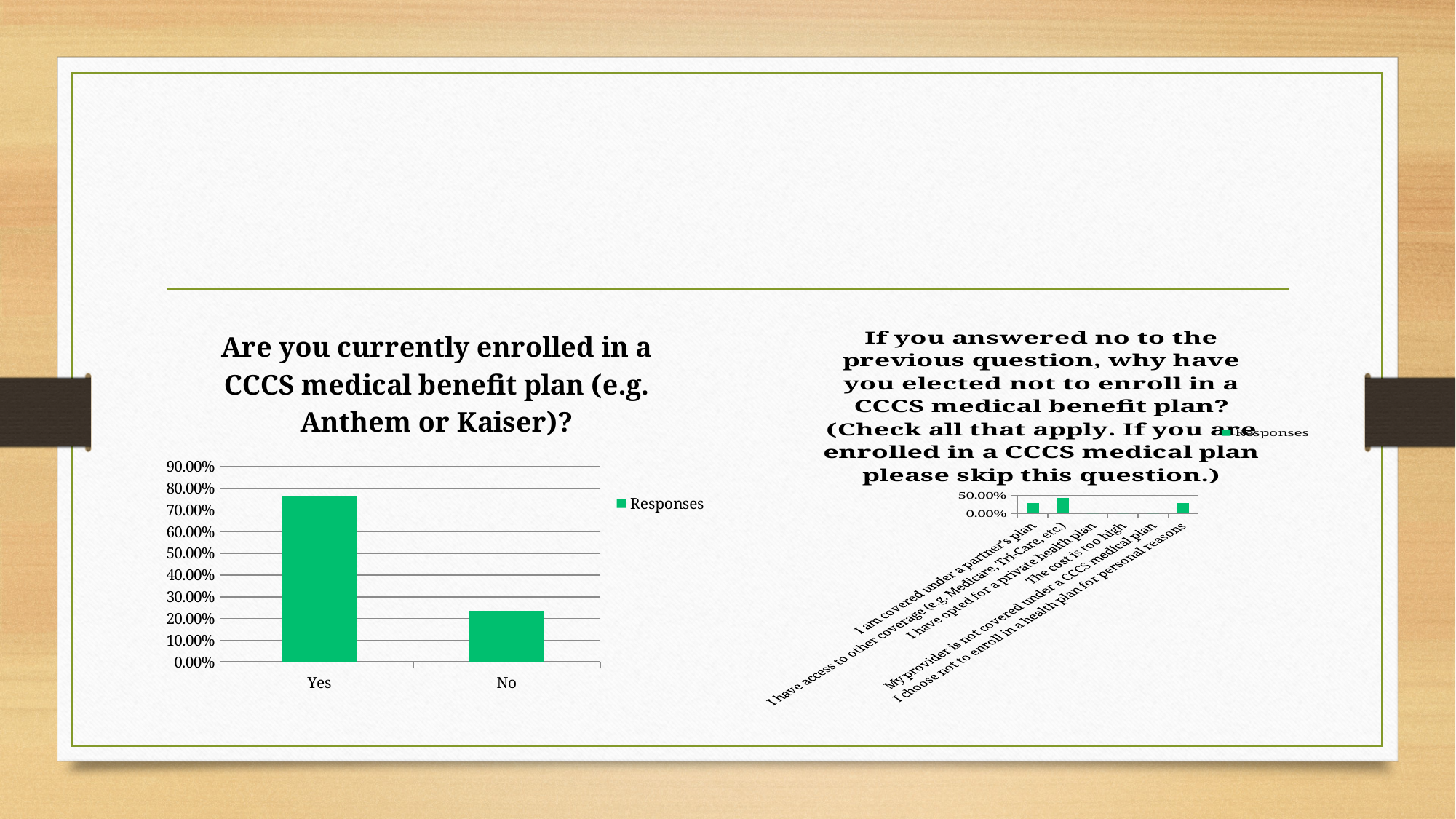
In the left chart ("Are you currently enrolled in a CCCS medical benefit plan"), which category has the highest value? Yes In the left chart ("Are you currently enrolled in a CCCS medical benefit plan"), is the value for No greater or less than 30.00%? less What is the name of the series in the legend of the left chart ("Are you currently enrolled in a CCCS medical benefit plan")? Responses In the left chart ("Are you currently enrolled in a CCCS medical benefit plan"), is the value for Yes greater or less than 80.00%? less How many categories are shown on the x axis of the left chart ("Are you currently enrolled in a CCCS medical benefit plan")? 2 In the left chart ("Are you currently enrolled in a CCCS medical benefit plan"), which category has the lowest value? No In the left chart ("Are you currently enrolled in a CCCS medical benefit plan"), is the value for Yes greater or less than 70.00%? greater How many series does the legend of the left chart ("Are you currently enrolled in a CCCS medical benefit plan") list? 1 What kind of chart is the left chart titled "Are you currently enrolled in a CCCS medical benefit plan (e.g. Anthem or Kaiser)?"? Bar chart In the right chart ("If you answered no to the previous question, why have you elected not to enroll in a CCCS medical benefit plan?"), which category has the highest value? I have access to other coverage (e.g. Medicare, Tri-Care, etc.) How many categories are shown on the x axis of the right chart ("If you answered no to the previous question, why have you elected not to enroll in a CCCS medical benefit plan?")? 6